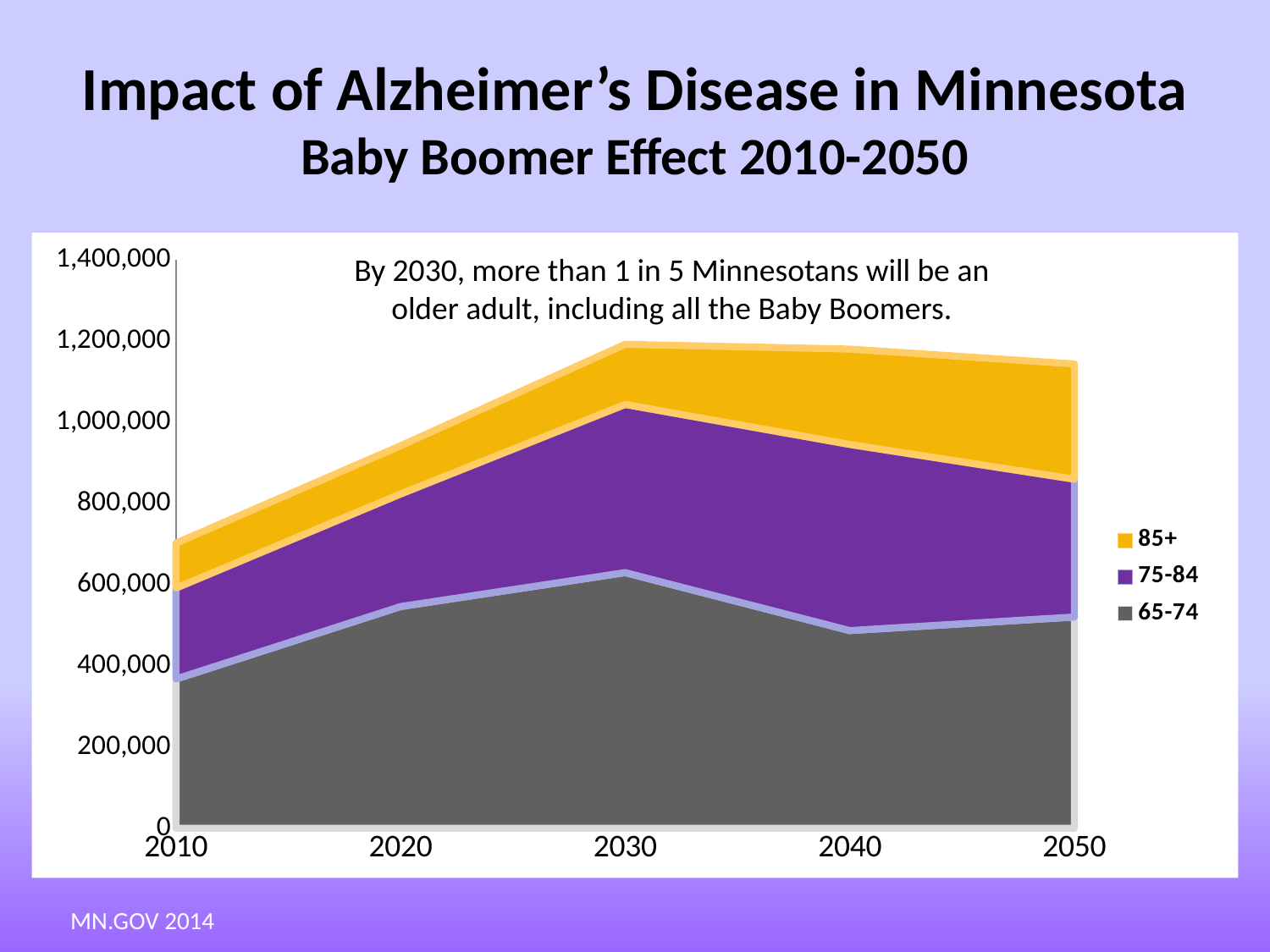
Is the value for the 65-74 series in 2010 greater or less than 400,000? less Is the total stacked value in 2050 greater or less than 1,000,000? greater Which series is shown in grey at the bottom of the stack? 65-74 In which year does the 65-74 series reach its highest value? 2030 Is the total stacked value in 2010 greater or less than 800,000? less What kind of chart is shown on the slide? Stacked area chart How many years are plotted along the x axis? 5 Does the 65-74 series rise or fall from 2010 to 2030? rise Which series is shown in yellow in the legend? 85+ How many series does the legend list? 3